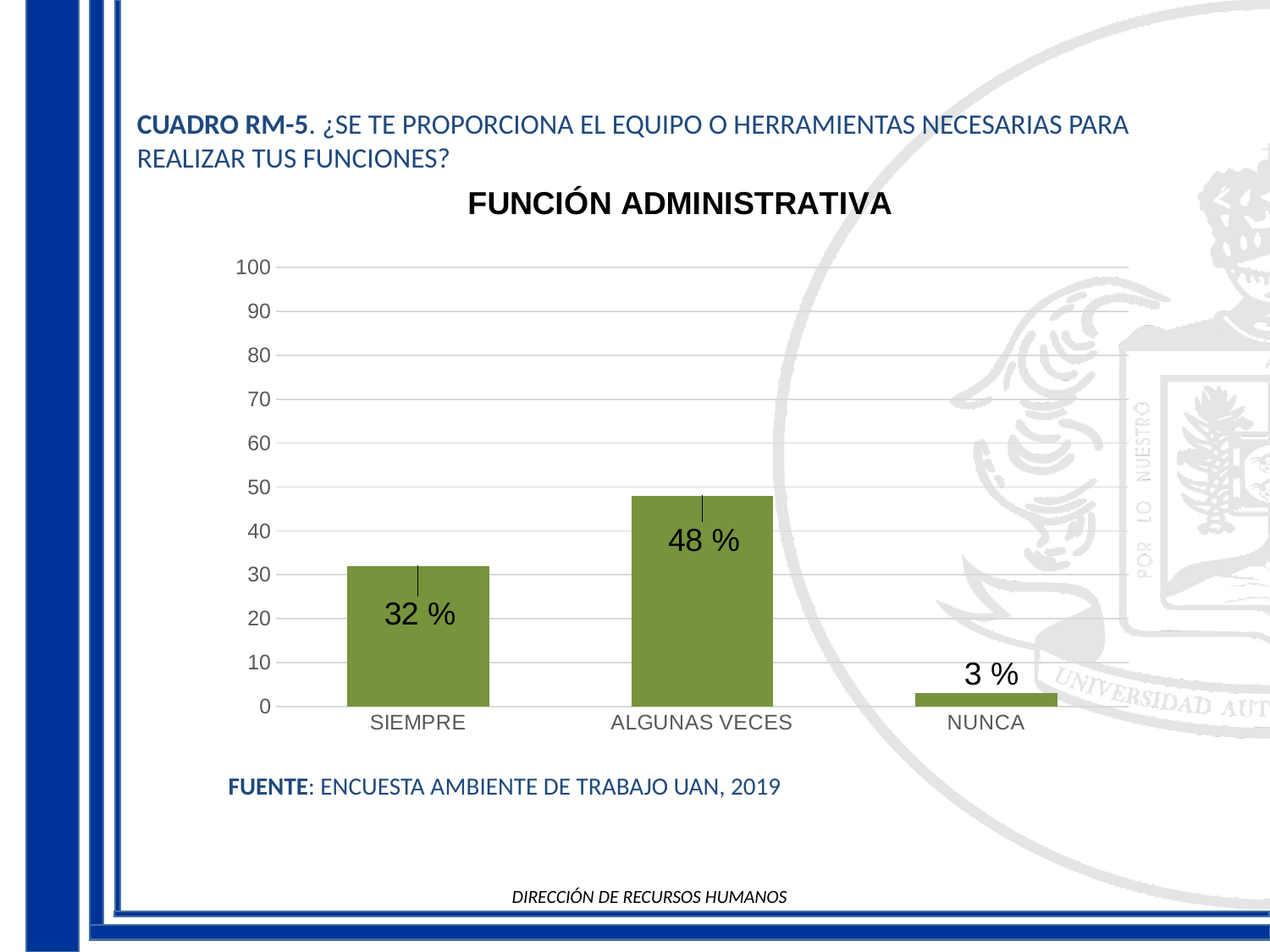
What is the difference between the values for ALGUNAS VECES and SIEMPRE? 16 % What is the highest value shown on the y axis? 100 What is the value for NUNCA? 3 % Which category has the highest value? ALGUNAS VECES How many categories are shown on the x axis? 3 Is the value for ALGUNAS VECES greater or less than 40? greater What kind of chart is shown on the slide? bar chart Which category has the lowest value? NUNCA What is the value for SIEMPRE? 32 % Which is larger, the value for SIEMPRE or the value for NUNCA? SIEMPRE What is the value for ALGUNAS VECES? 48 % What is the title of the chart? FUNCIÓN ADMINISTRATIVA